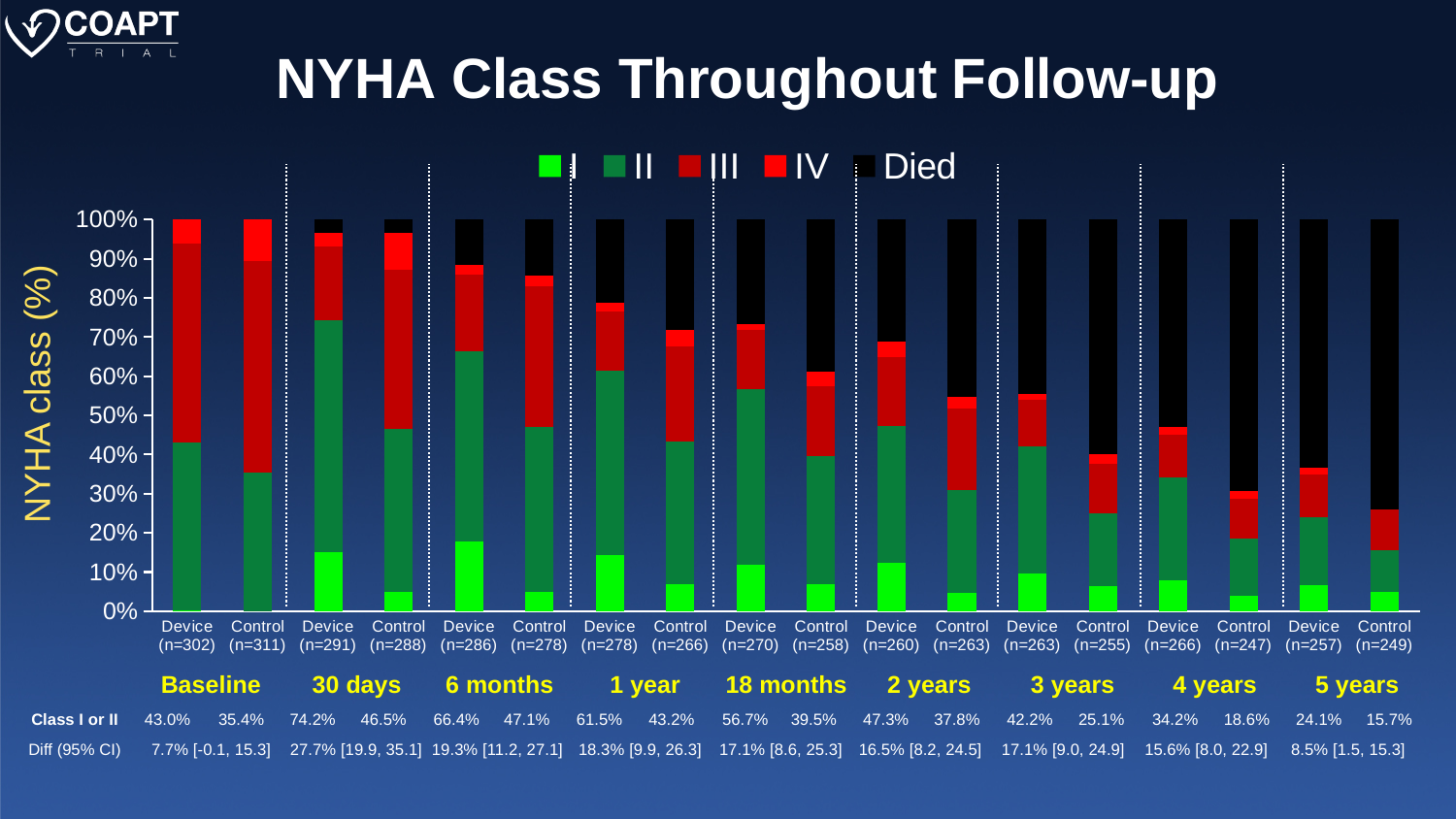
What is the Diff (95% CI) between Device and Control at 6 months? 19.3% [11.2, 27.1] What is the Class I or II percentage for the Device group at 30 days? 74.2% At 2 years, which group has the higher Class I or II percentage, Device or Control? Device From 30 days to 5 years, does the Class I or II percentage for the Device group rise or fall? Fall What is the difference between the Device and Control Class I or II percentages at 1 year? 18.3% What is the Class I or II percentage for the Control group at 5 years? 15.7% At which time point is the Class I or II percentage for the Control group lowest? 5 years At which time point is the Class I or II percentage for the Device group highest? 30 days How many follow-up time points are shown along the x axis? 9 What type of chart is shown on the slide? Stacked bar chart Is the combined share of classes I–IV (the non-Died portion) for the Control bar at 5 years greater or less than 30%? less How many series does the legend list? 5